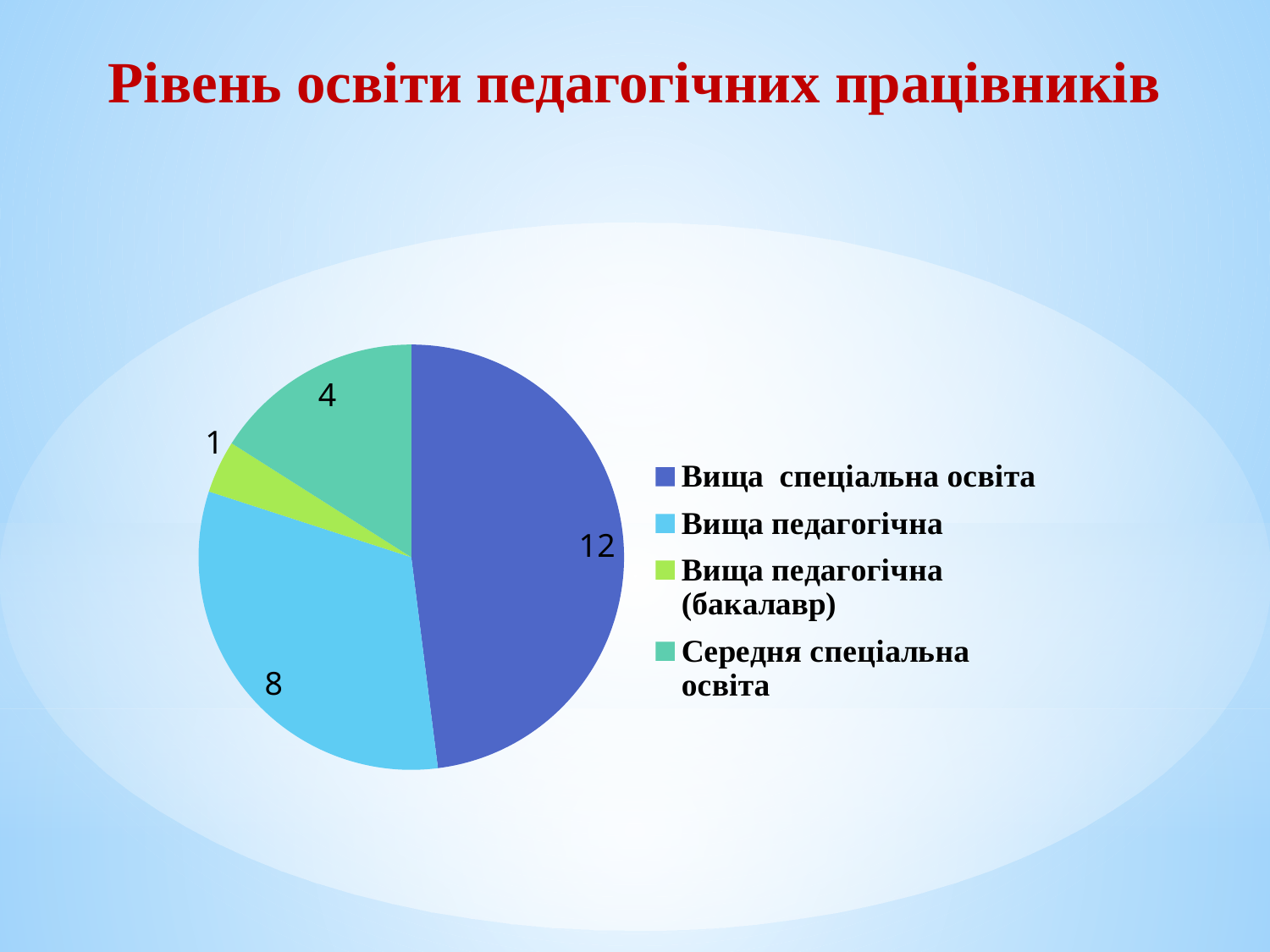
What is the value for Вища педагогічна? 8 Which category has the smallest slice of the pie? Вища педагогічна (бакалавр) Which category has the largest slice of the pie? Вища спеціальна освіта What is the value for Середня спеціальна освіта? 4 What is the value for Вища педагогічна (бакалавр)? 1 What is the title of the slide? Рівень освіти педагогічних працівників How many categories does the pie chart have? 4 What share of the pie does Вища спеціальна освіта represent? 48% Which is larger, the value for Середня спеціальна освіта or the value for Вища педагогічна (бакалавр)? Середня спеціальна освіта What type of chart is shown on the slide? pie chart What is the value for Вища спеціальна освіта? 12 What is the difference between the values for Вища спеціальна освіта and Вища педагогічна? 4